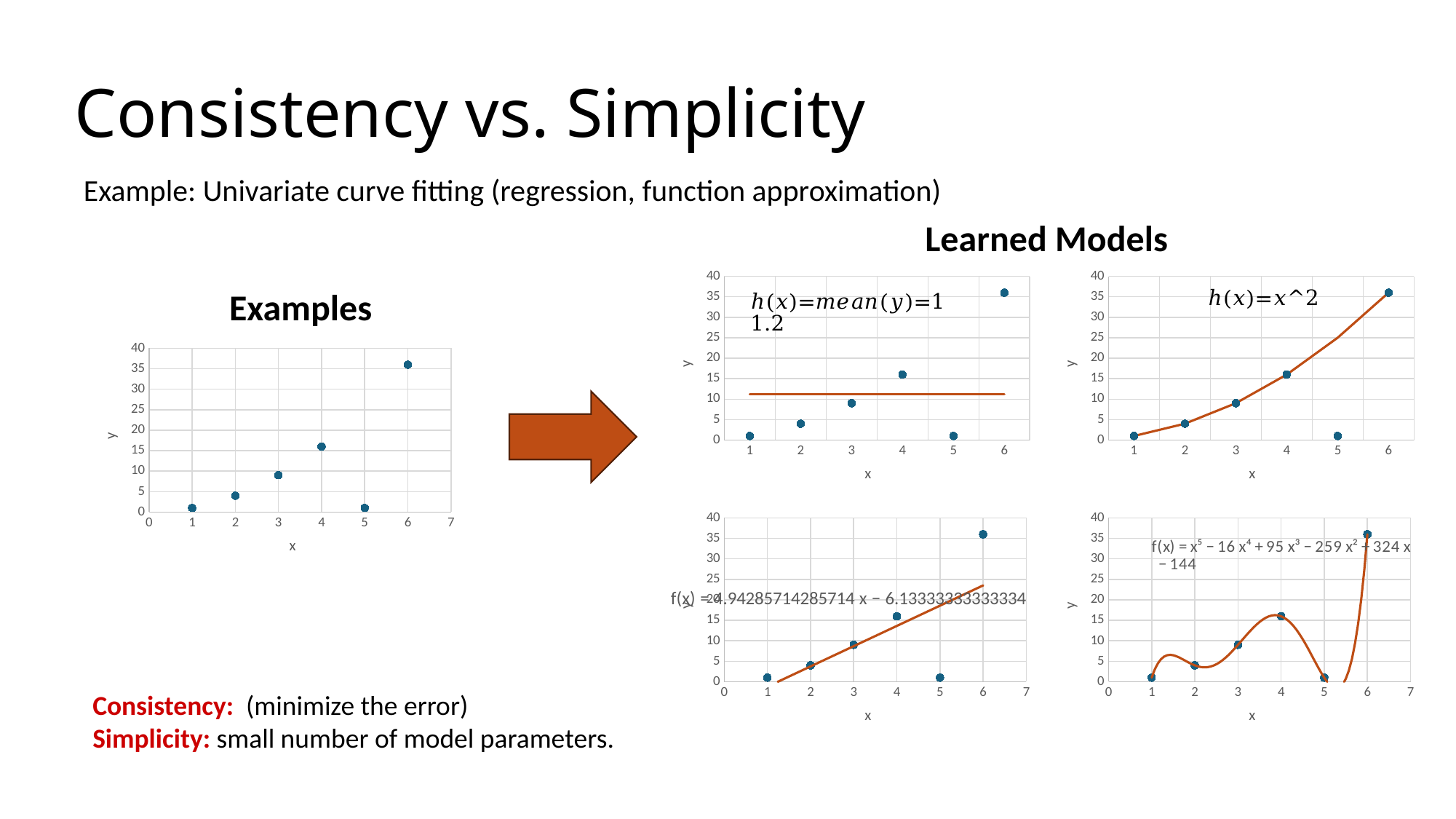
In the top-right "Learned Models" chart (h(x)=x^2), is the y value of the point at x = 5 greater or less than 5? less How many charts are shown under the "Learned Models" heading? 4 In the "Examples" chart, at which x value is the y value highest? 6 In the "Examples" chart, is the y value at x = 5 greater or less than 5? less How many data points are plotted in the "Examples" chart? 6 What kind of chart is the "Examples" chart on the left of the slide? scatter chart What is the highest value shown on the y axis of the "Examples" chart? 40 In the "Examples" chart, which has the larger y value: x = 3 or x = 4? x = 4 In the top-left "Learned Models" chart, what model equation is written on the chart? h(x)=mean(y)=11.2